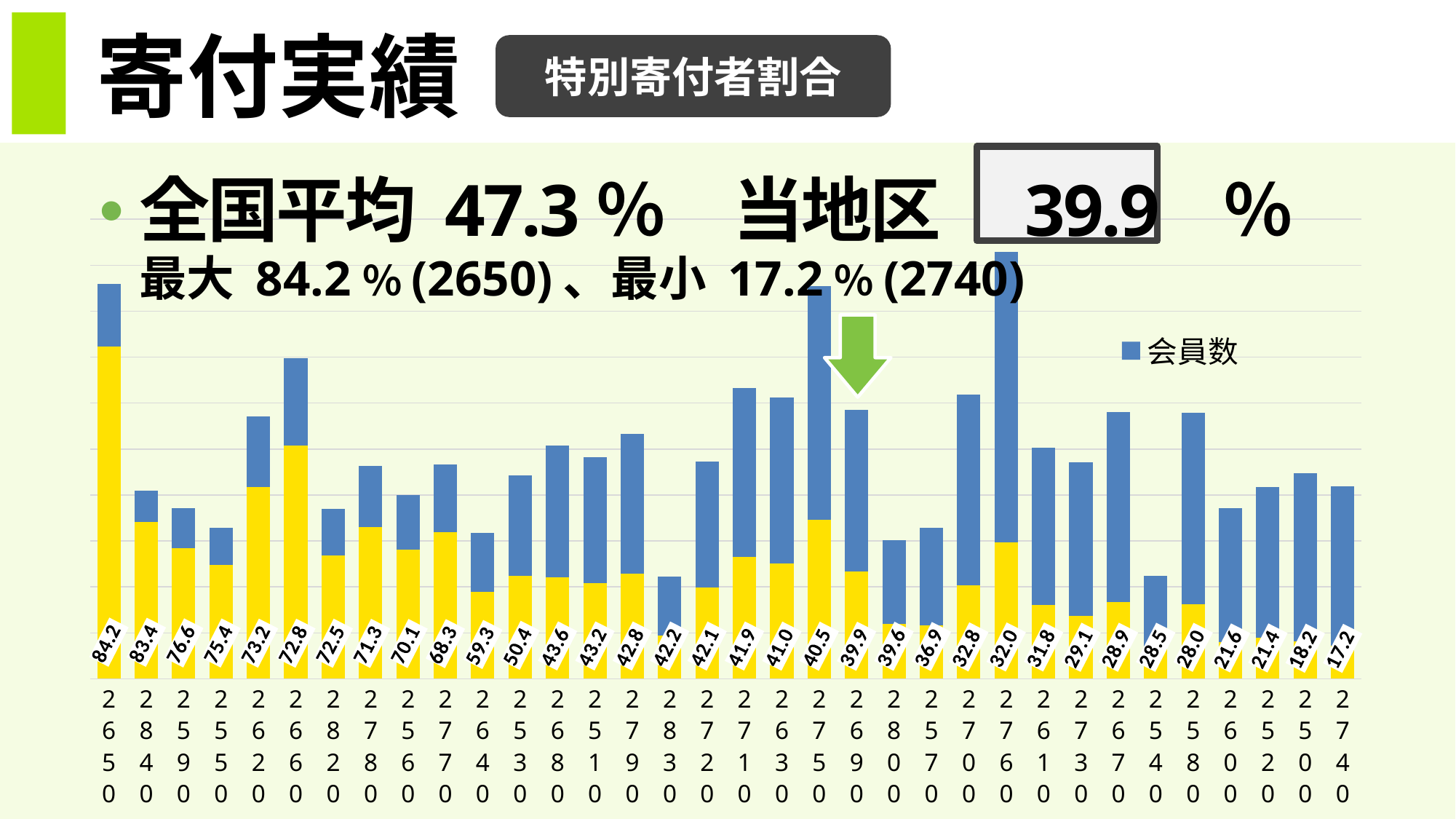
Which category has the lowest data label value? 2740 What kind of chart is shown? Bar chart What is the data label value for category 2660? 72.8 How many series does the legend list? 1 How many categories are shown on the x axis? 34 Do the data label values rise or fall from left to right along the x axis? Fall Which has the larger data label value, 2840 or 2590? 2840 What is the data label value for category 2740? 17.2 Which category has the highest data label value? 2650 What is the difference between the data label values for 2650 and 2740? 67.0 What is the data label value for category 2650? 84.2 What is the data label value for category 2690? 39.9